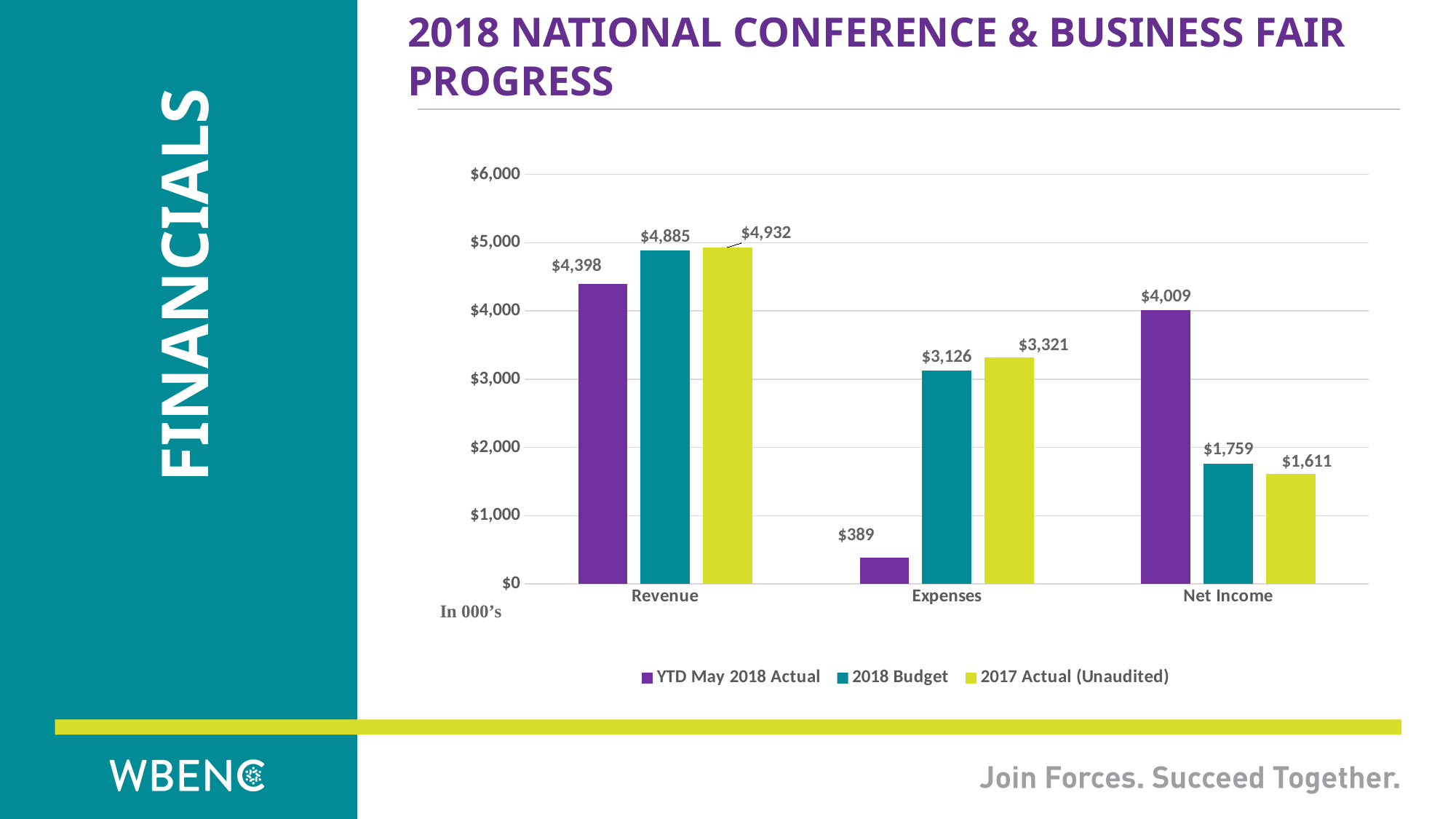
What is the YTD May 2018 Actual value for Expenses? $389 What is the YTD May 2018 Actual value for Revenue? $4,398 What is the 2017 Actual (Unaudited) value for Net Income? $1,611 Which category has the lowest 2018 Budget value? Net Income What kind of chart is shown on the slide? Bar chart Which category has the highest YTD May 2018 Actual value? Revenue Which is larger for Net Income: the YTD May 2018 Actual value or the 2018 Budget value? YTD May 2018 Actual How many series does the legend list? 3 How many categories are shown on the x axis? 3 What unit note is printed below the y axis of the chart? In 000's What is the difference between the 2017 Actual (Unaudited) and 2018 Budget values for Revenue? $47 What is the 2018 Budget value for Expenses? $3,126